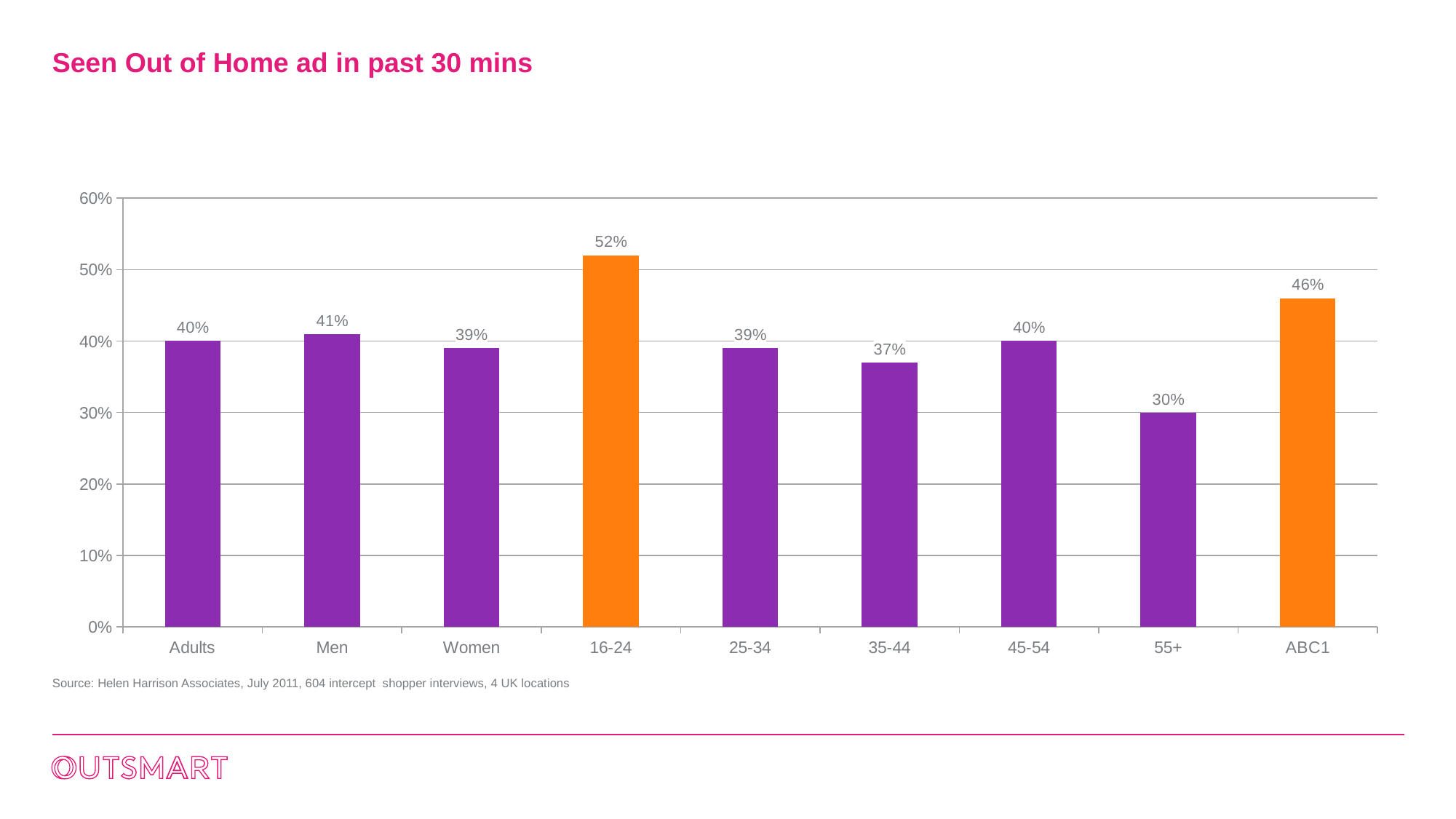
Which category has the highest value? 16-24 Is the value for ABC1 greater or less than 40%? greater What is the value for 16-24? 52% Which category has the lowest value? 55+ What is the title of the chart? Seen Out of Home ad in past 30 mins How many categories are shown on the x axis? 9 What is the value for ABC1? 46% What is the value for Men? 41% What kind of chart is shown on the slide? Bar chart What is the difference between the values for 16-24 and 55+? 22% What is the value for 55+? 30% Which is larger, the value for Men or the value for 35-44? Men